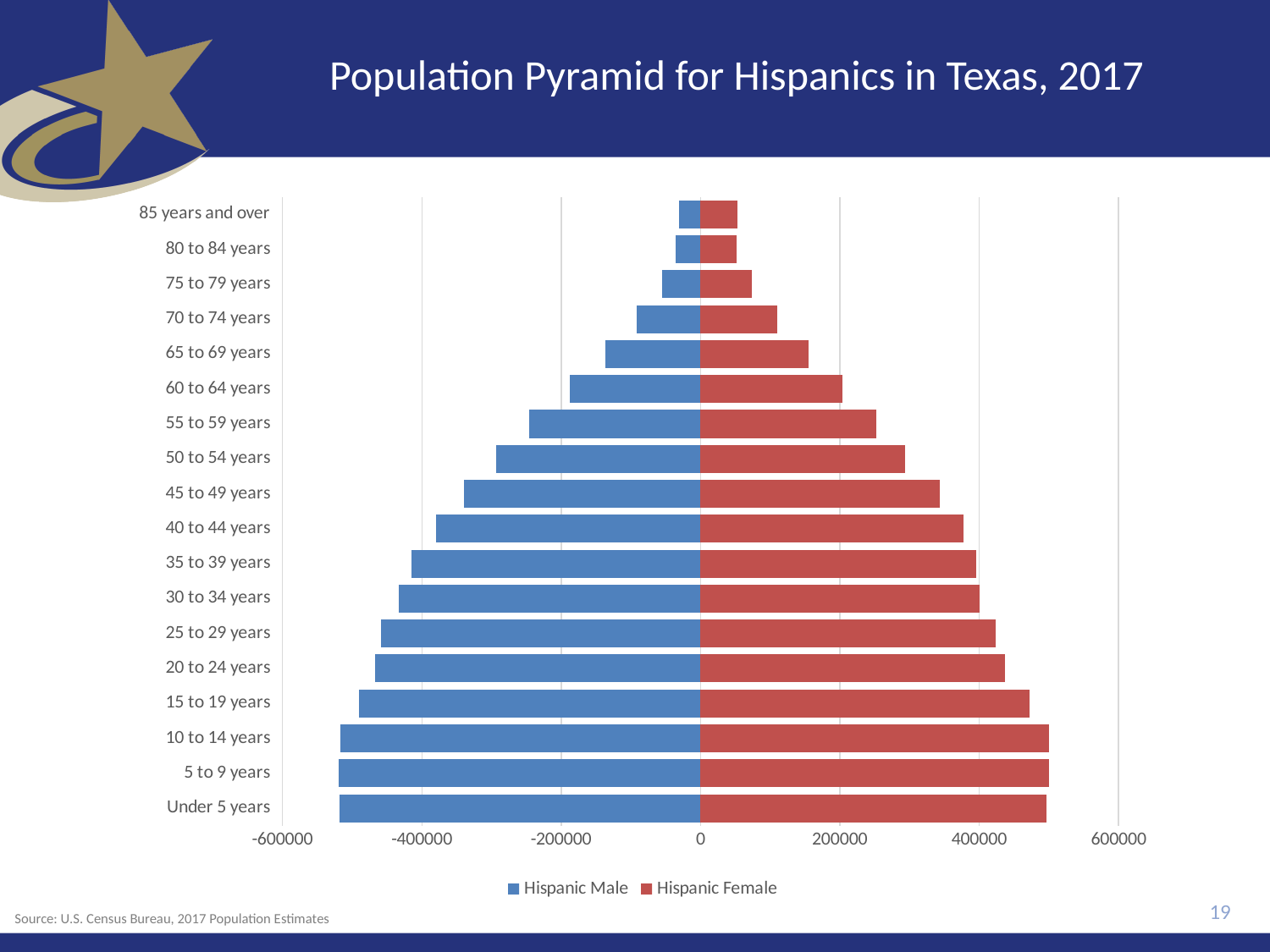
What is the title of the chart? Population Pyramid for Hispanics in Texas, 2017 Is the Hispanic Female value for 15 to 19 years greater or less than 400000? greater Is the Hispanic Male bar for 15 to 19 years plotted to the left or right of -400000? left Is the Hispanic Male bar for 45 to 49 years plotted to the left or right of -400000? right How many age-group categories are shown on the chart? 18 Which series is shown in red? Hispanic Female Which is larger for Hispanic Female: 55 to 59 years or 70 to 74 years? 55 to 59 years What kind of chart is shown on the slide? bar chart How many series does the legend list? 2 As the age groups get older, do the bars get longer or shorter? shorter